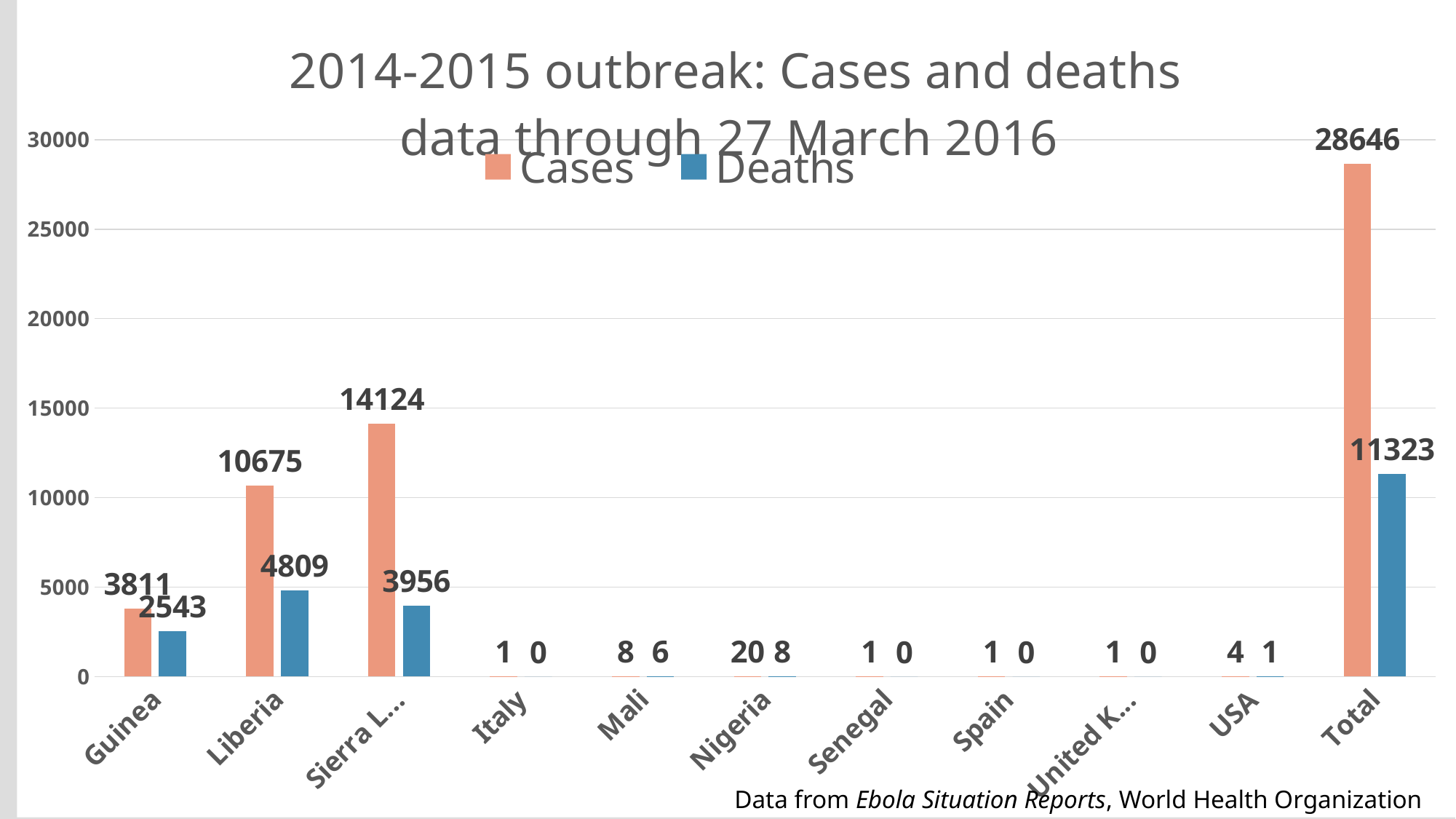
What is the difference between Cases and Deaths for Liberia? 5866 What is the title of the chart? 2014-2015 outbreak: Cases and deaths data through 27 March 2016 What is the number of Deaths for the Total category? 11323 What is the number of Cases for Liberia? 10675 How many series does the legend list? 2 How many categories are shown on the x axis? 11 What is the number of Cases for Nigeria? 20 Is the number of Cases for the Total category greater or less than 25000? greater Which is larger, the number of Deaths for Mali or the number of Deaths for USA? Mali What is the number of Deaths for Guinea? 2543 What type of chart is shown on the slide? bar chart Excluding the Total category, which country has the highest number of Deaths? Liberia